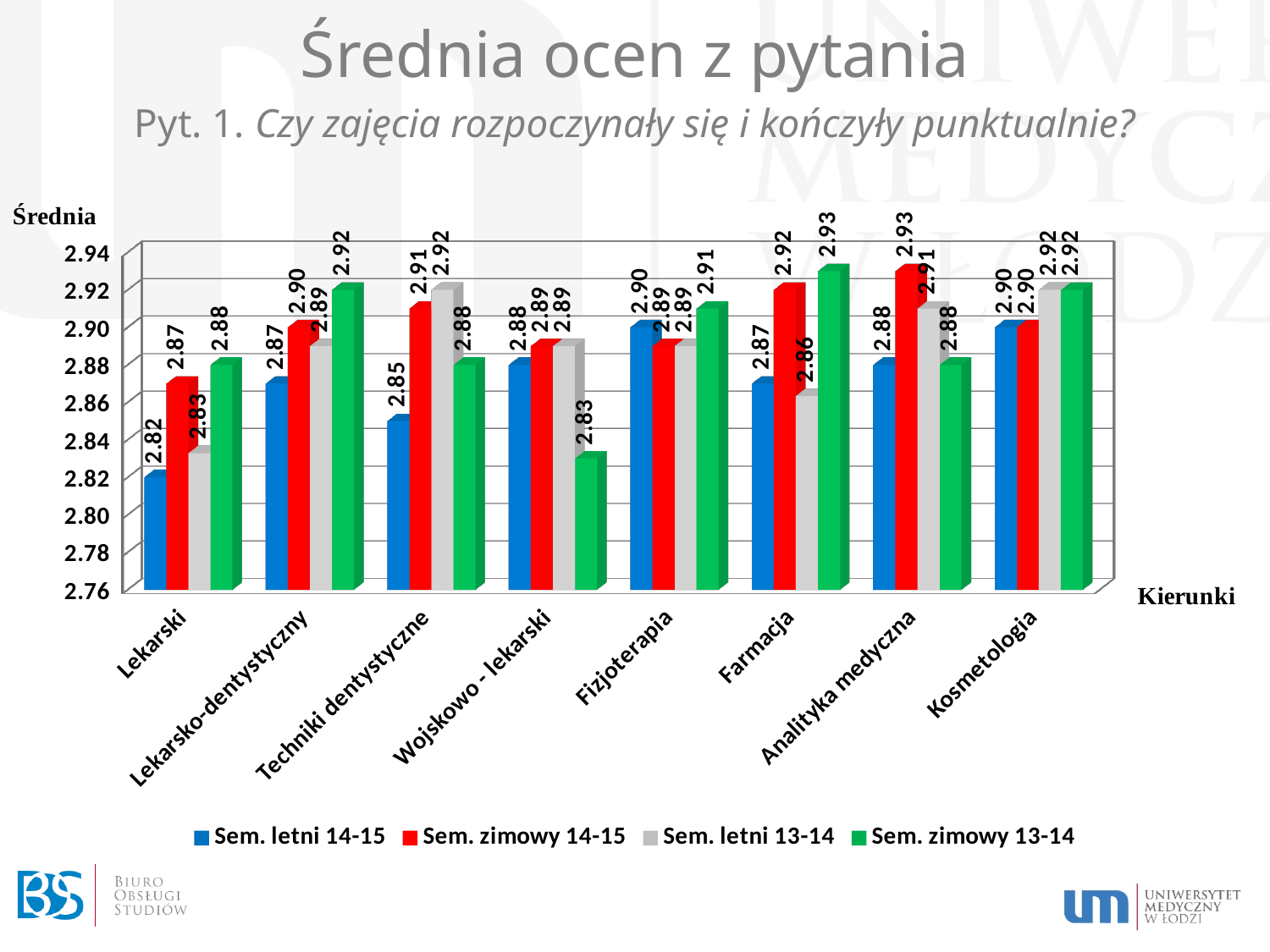
What is the value for Techniki dentystyczne in the Sem. letni 13-14 series? 2.92 How many categories (kierunki) are shown on the x axis? 8 Which category has the lowest value in the Sem. letni 14-15 series? Lekarski What is the value for Lekarski in the Sem. letni 14-15 series? 2.82 What is the value for Farmacja in the Sem. zimowy 13-14 series? 2.93 What kind of chart is shown on the slide? Bar chart Which category has the highest value in the Sem. zimowy 14-15 series? Analityka medyczna What is the difference between the Sem. zimowy 13-14 value and the Sem. letni 14-15 value for Lekarsko-dentystyczny? 0.05 What is the value for Wojskowo - lekarski in the Sem. zimowy 13-14 series? 2.83 How many series does the legend list? 4 Which series is shown in green in the legend? Sem. zimowy 13-14 Which is larger for Farmacja: the Sem. zimowy 14-15 value or the Sem. letni 13-14 value? Sem. zimowy 14-15